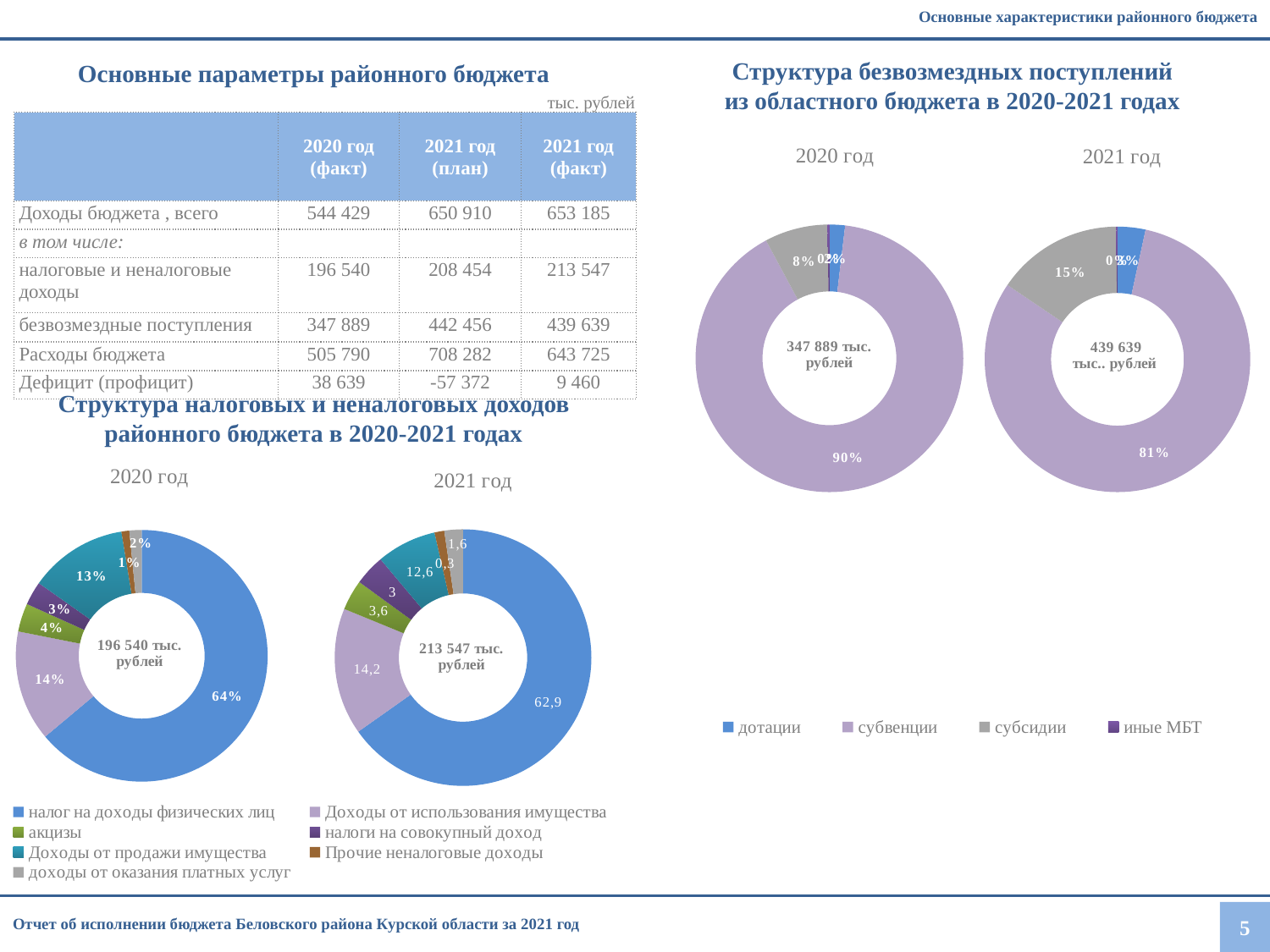
In the 2021 год chart under "Структура налоговых и неналоговых доходов", what value is shown for акцизы? 3,6 In the 2021 год chart under "Структура безвозмездных поступлений из областного бюджета", what share is shown for субсидии? 15% What total is printed in the centre of the 2021 год chart under "Структура налоговых и неналоговых доходов"? 213 547 тыс. рублей What kind of chart is used for the 2020 год chart under "Структура налоговых и неналоговых доходов районного бюджета в 2020-2021 годах"? doughnut chart In the 2020 год chart under "Структура безвозмездных поступлений из областного бюджета", which category has the largest share? субвенции In the 2020 год chart under "Структура безвозмездных поступлений из областного бюджета", what share is shown for субсидии? 8% In the 2020 год chart under "Структура налоговых и неналоговых доходов", by how many percentage points does налог на доходы физических лиц exceed Доходы от использования имущества? 50 percentage points In the 2020 год chart under "Структура налоговых и неналоговых доходов", what share is shown for налог на доходы физических лиц? 64% In the 2021 год chart under "Структура налоговых и неналоговых доходов", what value is shown for Доходы от использования имущества? 14,2 In the 2020 год chart under "Структура налоговых и неналоговых доходов", which is larger: Доходы от продажи имущества or акцизы? Доходы от продажи имущества How many categories does the legend of the "Структура налоговых и неналоговых доходов районного бюджета" charts list? 7 How many categories does the legend of the "Структура безвозмездных поступлений из областного бюджета" charts list? 4